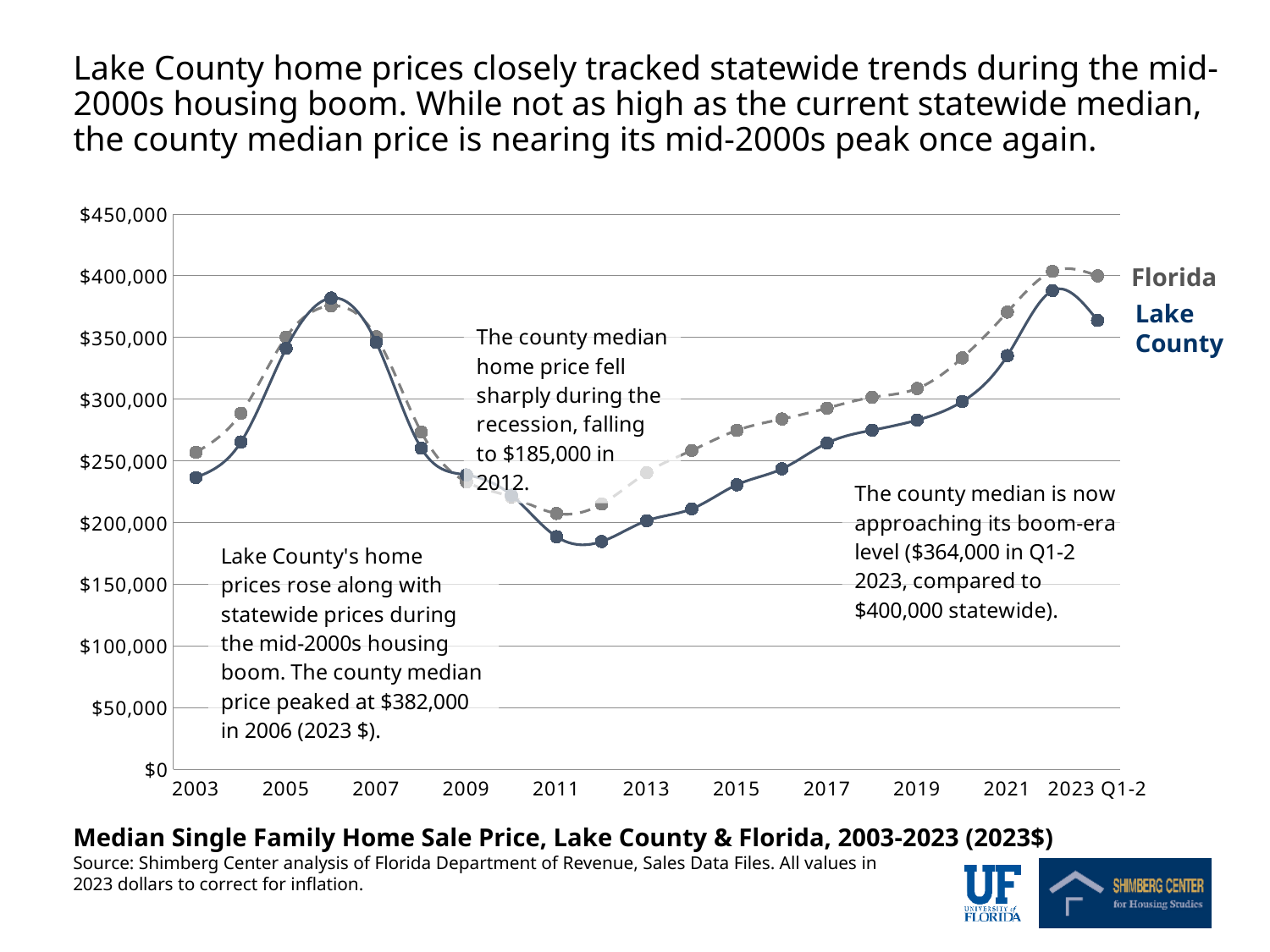
What is the difference between Lake County's 2006 peak and its 2012 low? $197,000 How much higher is the Florida median than the Lake County median in Q1-2 2023? $36,000 What was Lake County's peak median home price in 2006 (2023 $)? $382,000 In Q1-2 2023, which is larger: the Florida median or the Lake County median? Florida What was the Lake County median home price in 2012? $185,000 Is the Florida value for 2021 greater or less than $350,000? greater What kind of chart is shown on the slide? line chart What is the Lake County median home price in Q1-2 2023? $364,000 What is the Florida statewide median home price in Q1-2 2023? $400,000 How many series does the chart plot? 2 In which year was the Lake County median home price lowest? 2012 Is the Lake County value for 2003 greater or less than $250,000? less